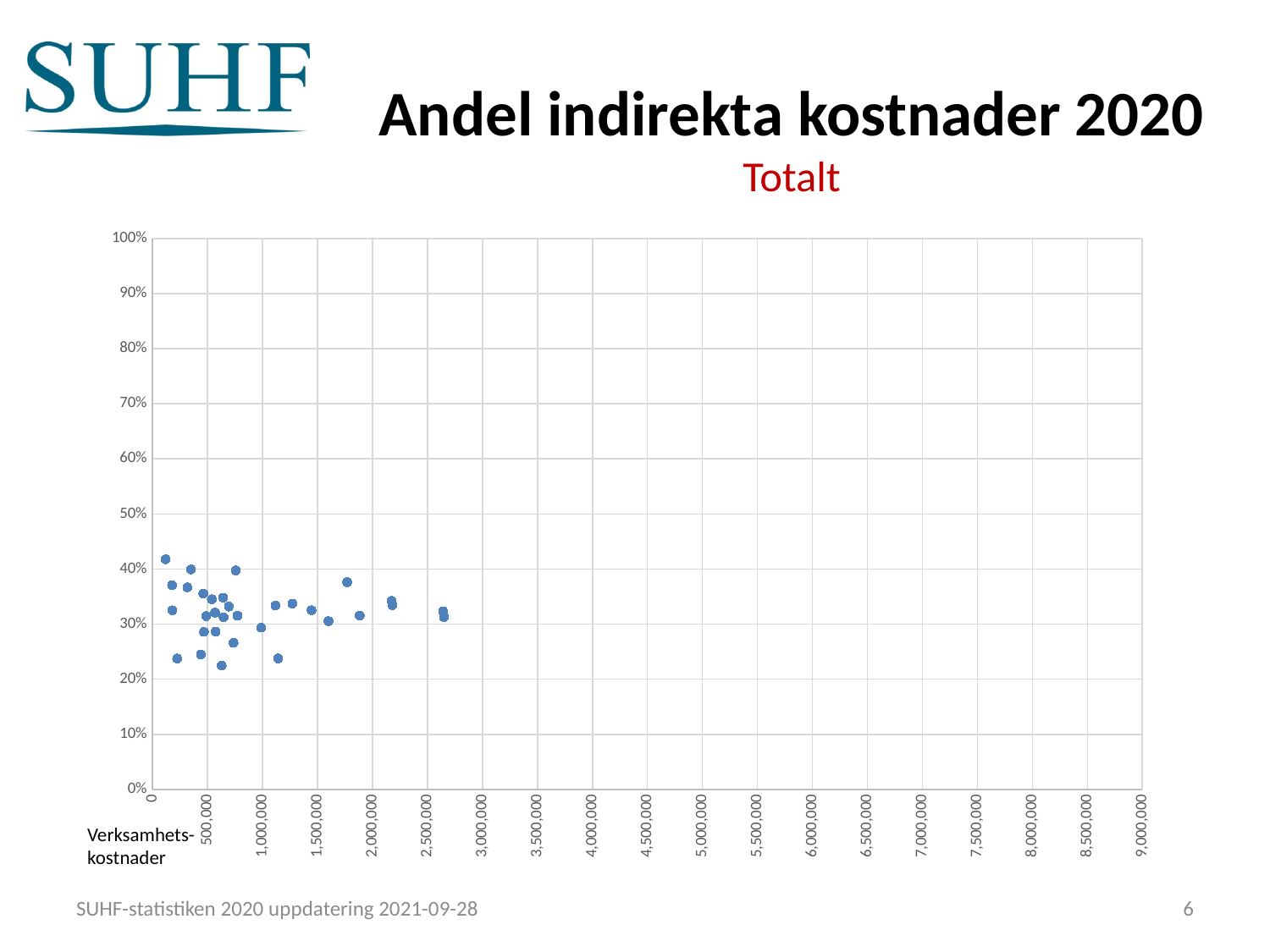
Is the highest plotted point on the chart greater or less than 50%? less Is the lowest plotted point on the chart greater or less than 30%? less Are any points plotted beyond 3,000,000 on the horizontal axis? No What is the maximum value shown on the vertical axis? 100% What label is shown for the horizontal axis of the chart? Verksamhetskostnader What kind of chart is shown on the slide? scatter chart What is the title of the chart on the slide? Andel indirekta kostnader 2020